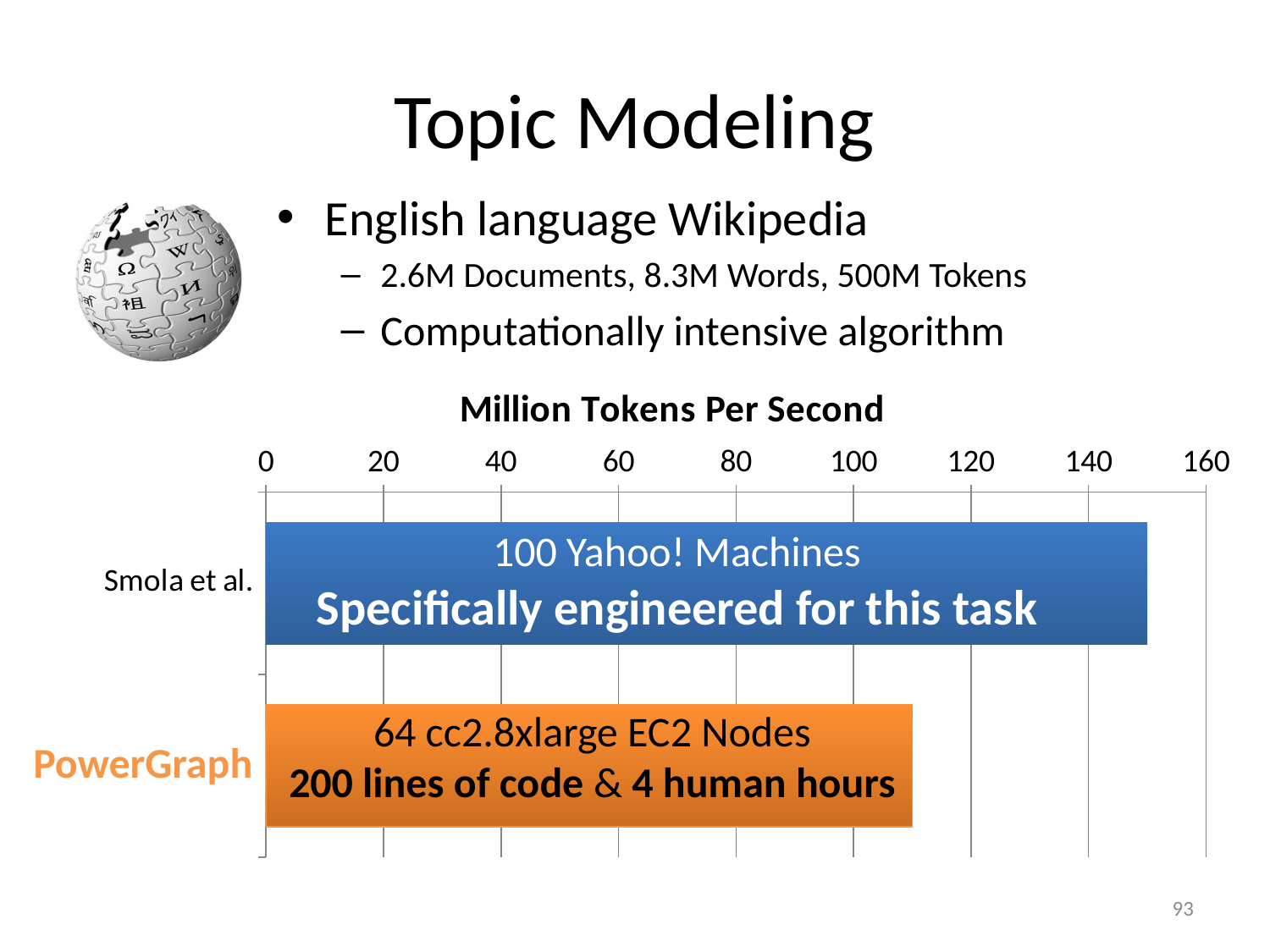
Which category has the highest value in the Million Tokens Per Second chart? Smola et al. What is the title of the chart? Million Tokens Per Second Is the value for PowerGraph greater or less than 100? greater What colour is the PowerGraph bar? orange Is the value for Smola et al. greater or less than 160? less What is the maximum value shown on the chart's horizontal axis? 160 How many categories (bars) does the chart show? 2 Which category has the lowest value in the Million Tokens Per Second chart? PowerGraph Is the value for Smola et al. greater or less than 140? greater Which has a larger value, Smola et al. or PowerGraph? Smola et al. What kind of chart is shown on the slide? bar chart